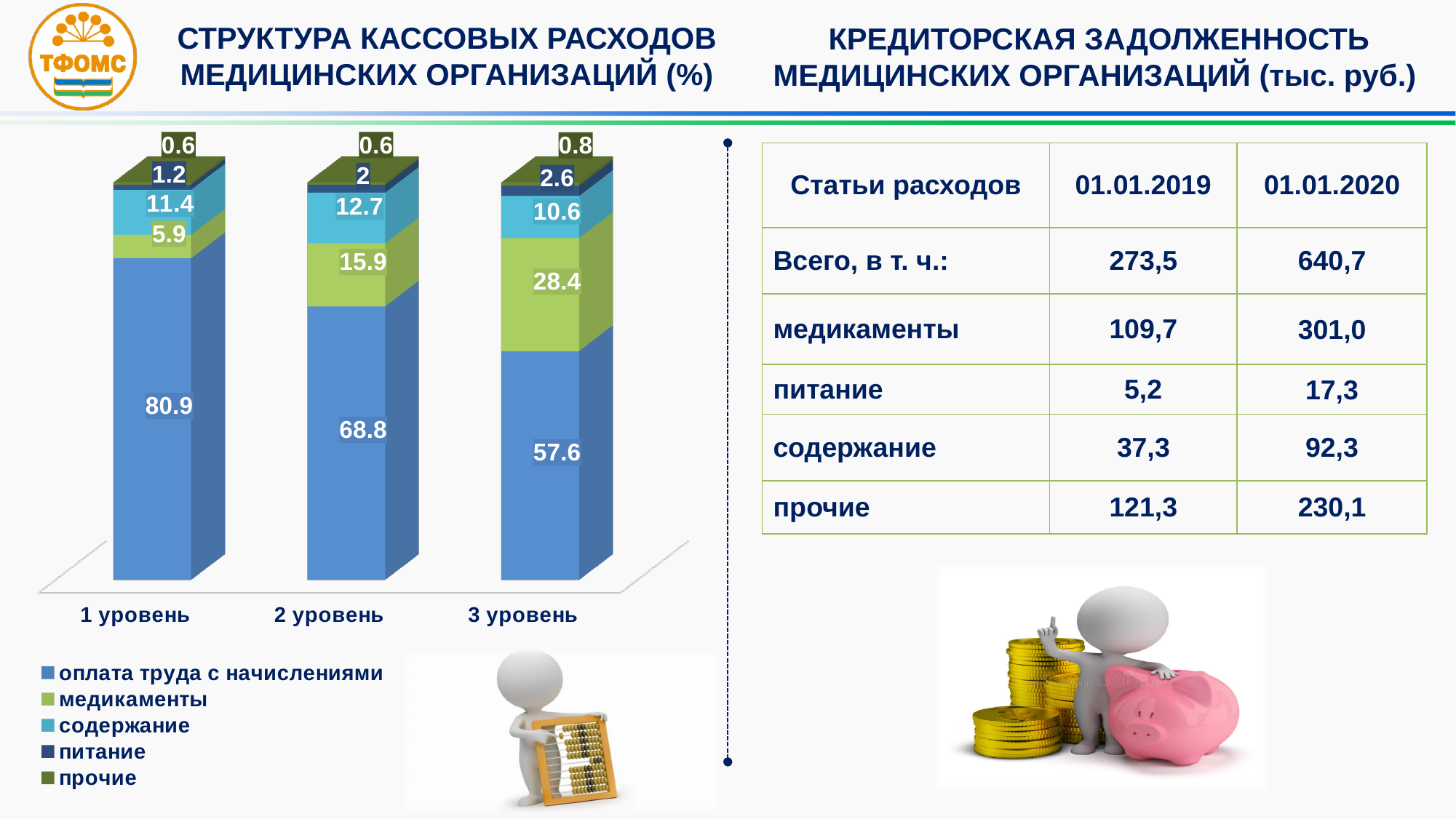
In the bar chart, which level has the lowest value for 'медикаменты'? 1 уровень How many categories (levels) are shown on the x axis of the bar chart? 3 In the bar chart, what is the difference between the 'оплата труда с начислениями' values for '1 уровень' and '3 уровень'? 23.3 In the bar chart, what is the value of 'медикаменты' for '3 уровень'? 28.4 In the bar chart, is the 'содержание' value larger for '1 уровень' or '3 уровень'? 1 уровень In the bar chart, what is the value of 'оплата труда с начислениями' for '1 уровень'? 80.9 In the bar chart, which level has the highest value for 'оплата труда с начислениями'? 1 уровень In the bar chart, what is the value of 'содержание' for '2 уровень'? 12.7 How many series does the legend of the bar chart list? 5 In the bar chart, what is the value of 'питание' for '3 уровень'? 2.6 What type of chart is shown on the left side of the slide? Stacked bar chart In the bar chart, does the 'оплата труда с начислениями' value rise or fall from '1 уровень' to '3 уровень'? Fall